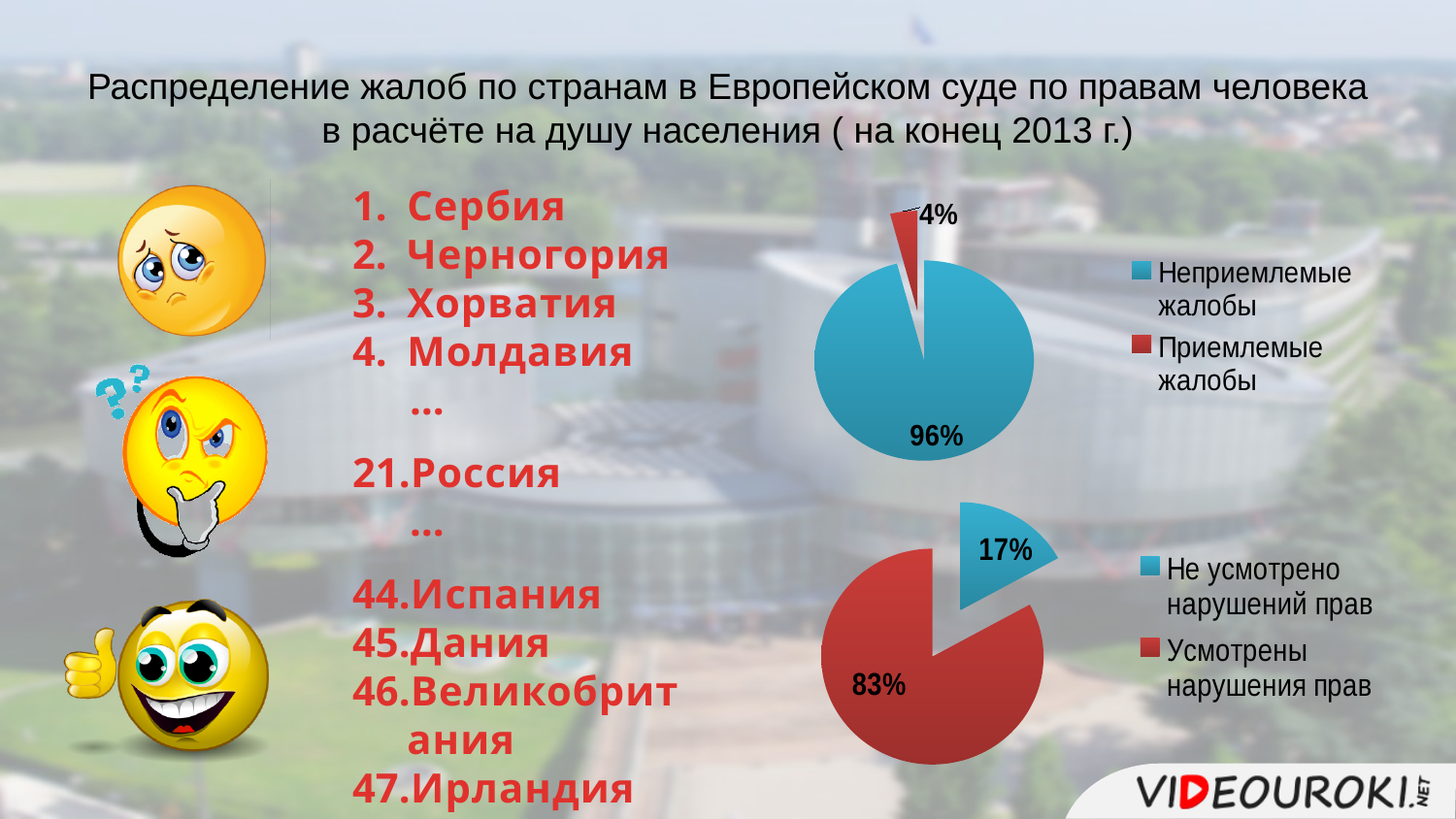
How many categories does the legend of the bottom pie chart list? 2 In the top pie chart, what share is labelled for "Приемлемые жалобы"? 4% In the bottom pie chart, which is larger: "Усмотрены нарушения прав" or "Не усмотрено нарушений прав"? Усмотрены нарушения прав In the top pie chart, what colour is the slice for "Приемлемые жалобы"? Red In the bottom pie chart, what share is labelled for "Усмотрены нарушения прав"? 83% What type of chart is the top chart on the slide? Pie chart In the top pie chart, what is the difference in percentage points between "Неприемлемые жалобы" and "Приемлемые жалобы"? 92 In the bottom pie chart, what share is labelled for "Не усмотрено нарушений прав"? 17% In the top pie chart, which category has the largest slice? Неприемлемые жалобы In the bottom pie chart, which category has the smallest slice? Не усмотрено нарушений прав In the top pie chart, what share is labelled for "Неприемлемые жалобы"? 96% In the bottom pie chart, what is the difference in percentage points between "Усмотрены нарушения прав" and "Не усмотрено нарушений прав"? 66